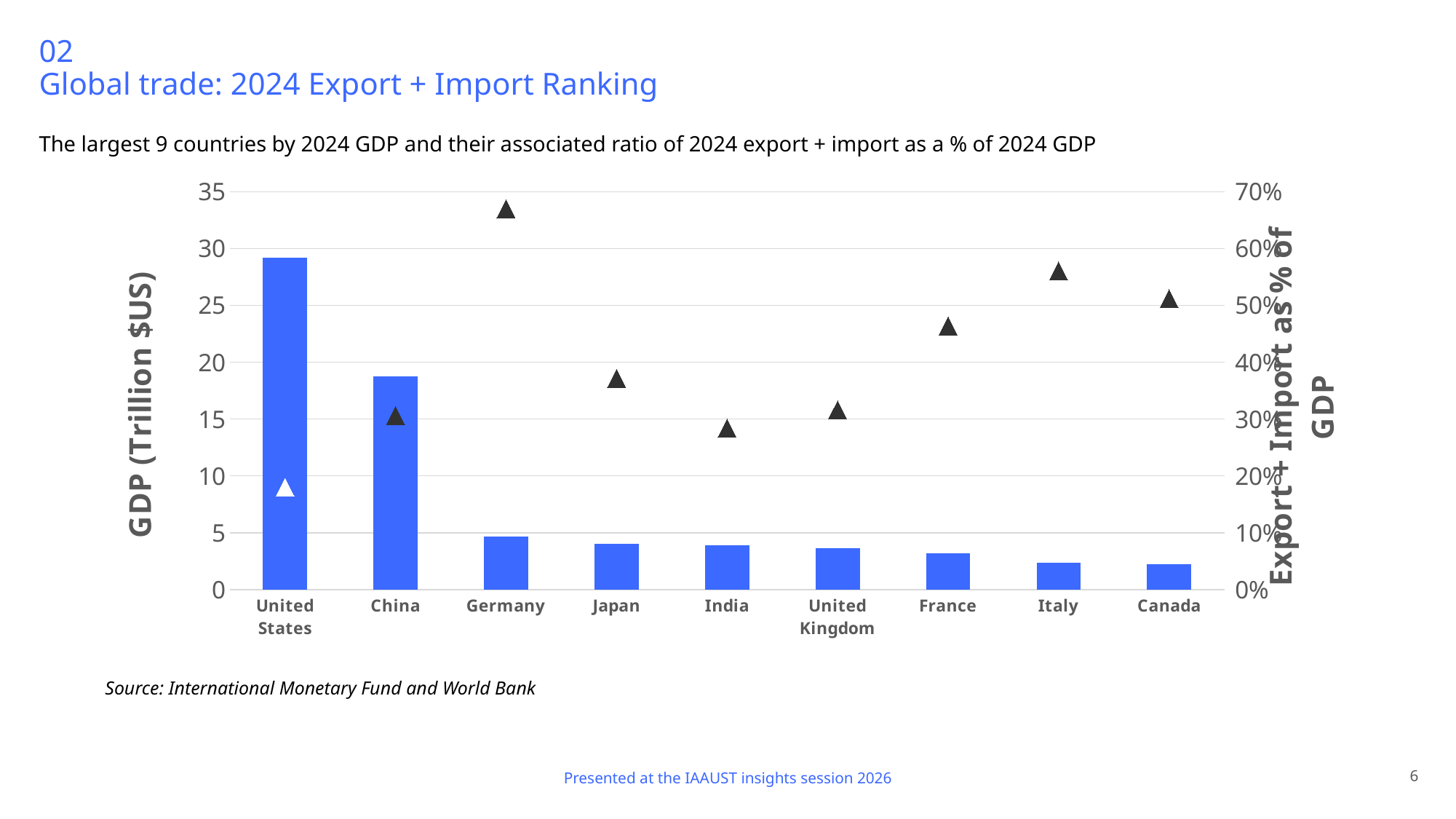
Which country has the tallest GDP bar? United States Is the Export + Import as % of GDP value for Japan greater or less than 40%? less Is the GDP value for the United States greater or less than 25 trillion $US? greater Which country has the highest Export + Import as % of GDP marker? Germany Which country has the lowest Export + Import as % of GDP marker? United States Which country has the shortest GDP bar? Canada Is the GDP value for China greater or less than 20 trillion $US? less How many countries are shown on the x axis of the chart? 9 Which has the larger GDP bar, China or Germany? China Do the GDP bars rise or fall moving from left to right along the x axis? fall What kind of chart is shown on the slide? A bar chart combined with triangle markers (combo chart)